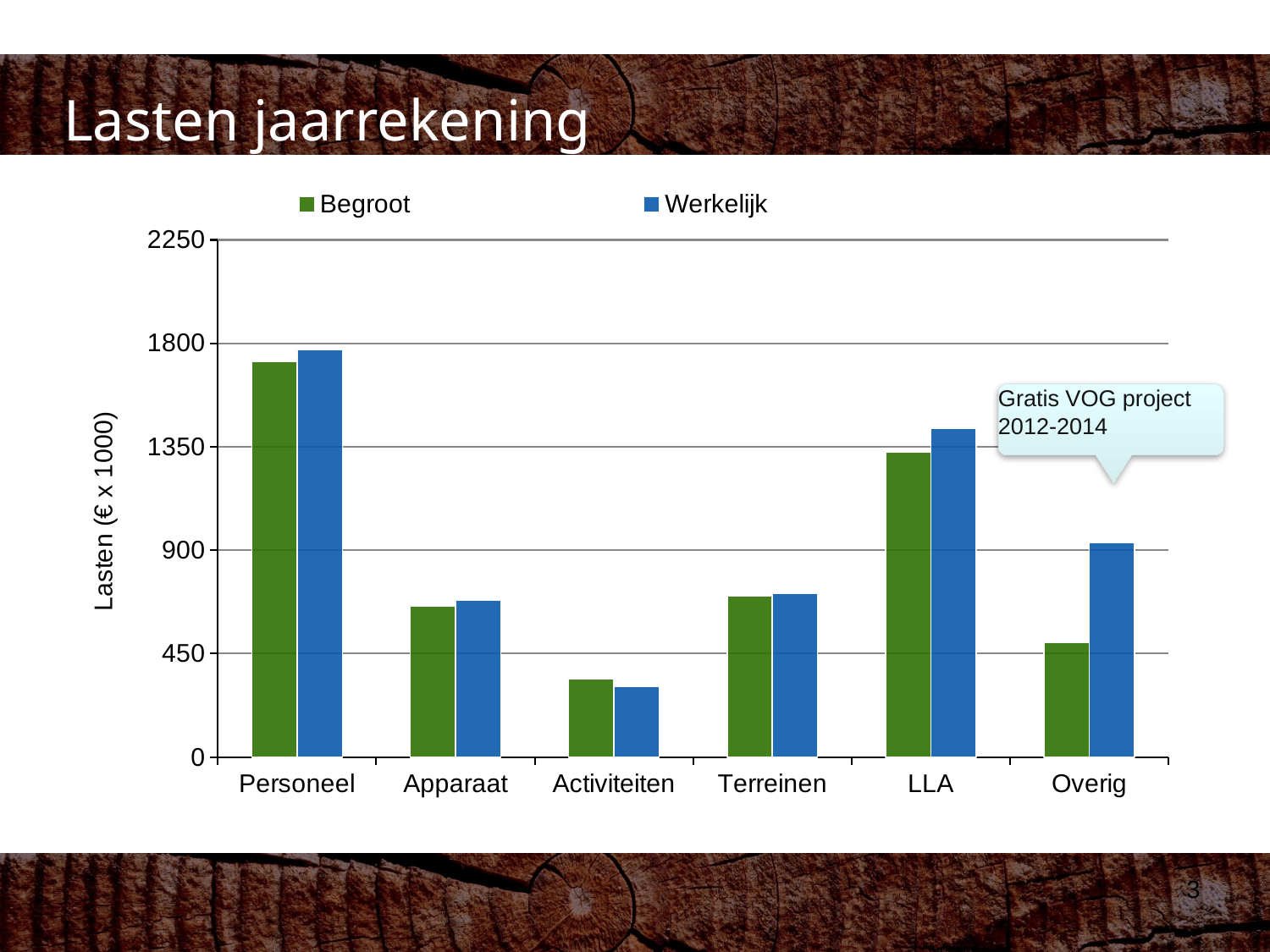
For Overig, which is larger: Begroot or Werkelijk? Werkelijk What kind of chart is shown on the slide? bar chart What does the callout next to the Overig bars say? Gratis VOG project 2012-2014 Is the Werkelijk value for LLA greater or less than 1350? greater How many categories are shown on the x axis of the chart? 6 Which category has the lowest Begroot value? Activiteiten Is the Werkelijk value for Activiteiten greater or less than 450? less Is the Begroot value for Personeel greater or less than 1350? greater For Activiteiten, which is larger: Begroot or Werkelijk? Begroot Which category has the highest Werkelijk value? Personeel What is the label of the y axis? Lasten (€ x 1000) How many series does the legend list? 2